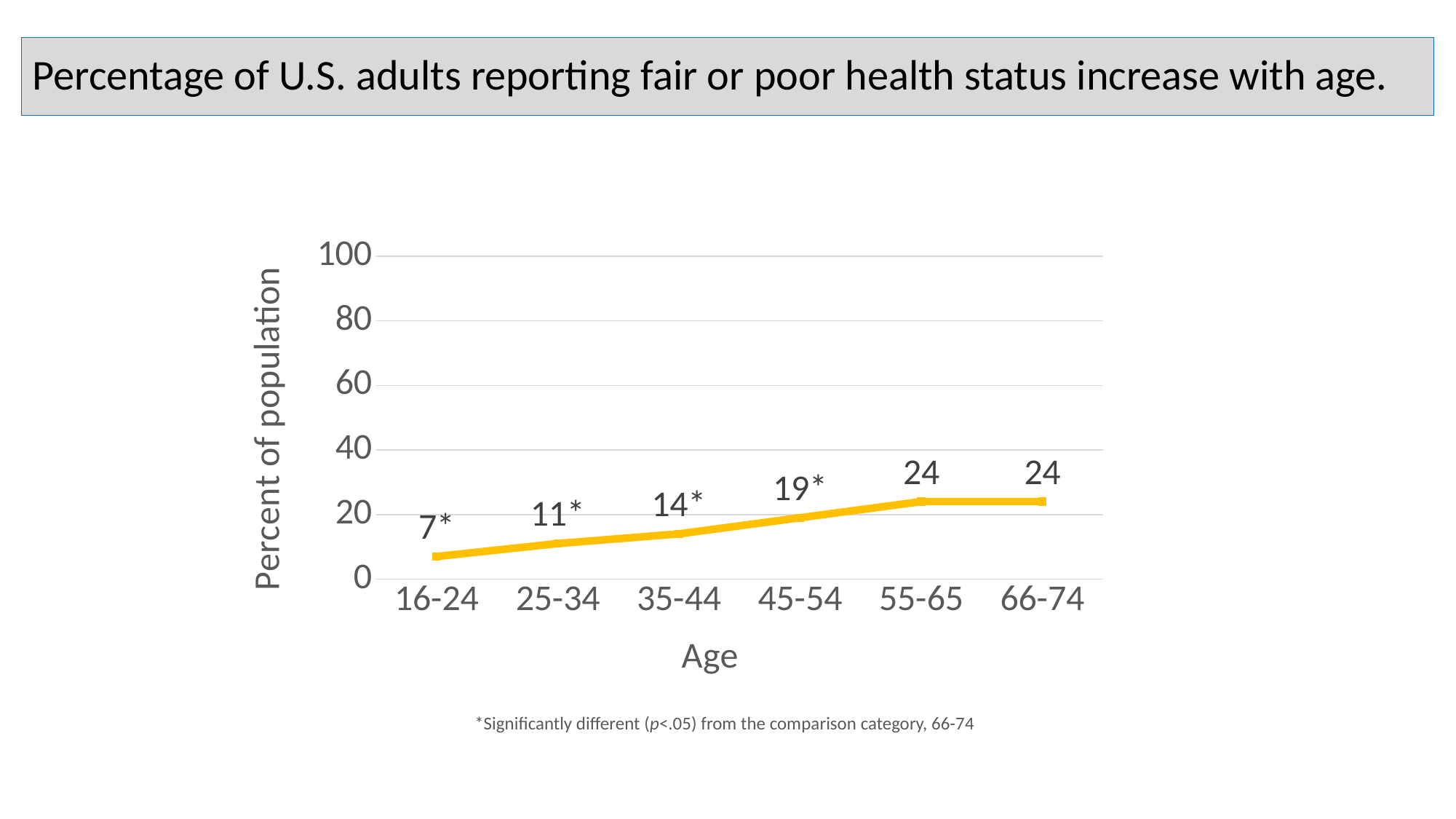
What is the value for the 66-74 age group? 24 Which is larger, the value for 35-44 or the value for 25-34? 35-44 What kind of chart is shown on the slide? line chart What is the value for the 35-44 age group? 14 How many age groups are plotted on the x axis? 6 Do the values generally rise or fall as age increases along the x axis? rise Is the value for 66-74 greater or less than 40? less What is the value for the 45-54 age group? 19 What is the difference between the values for 55-65 and 16-24? 17 Which age group has the lowest value? 16-24 What is the difference between the values for 45-54 and 25-34? 8 What is the value for the 16-24 age group? 7